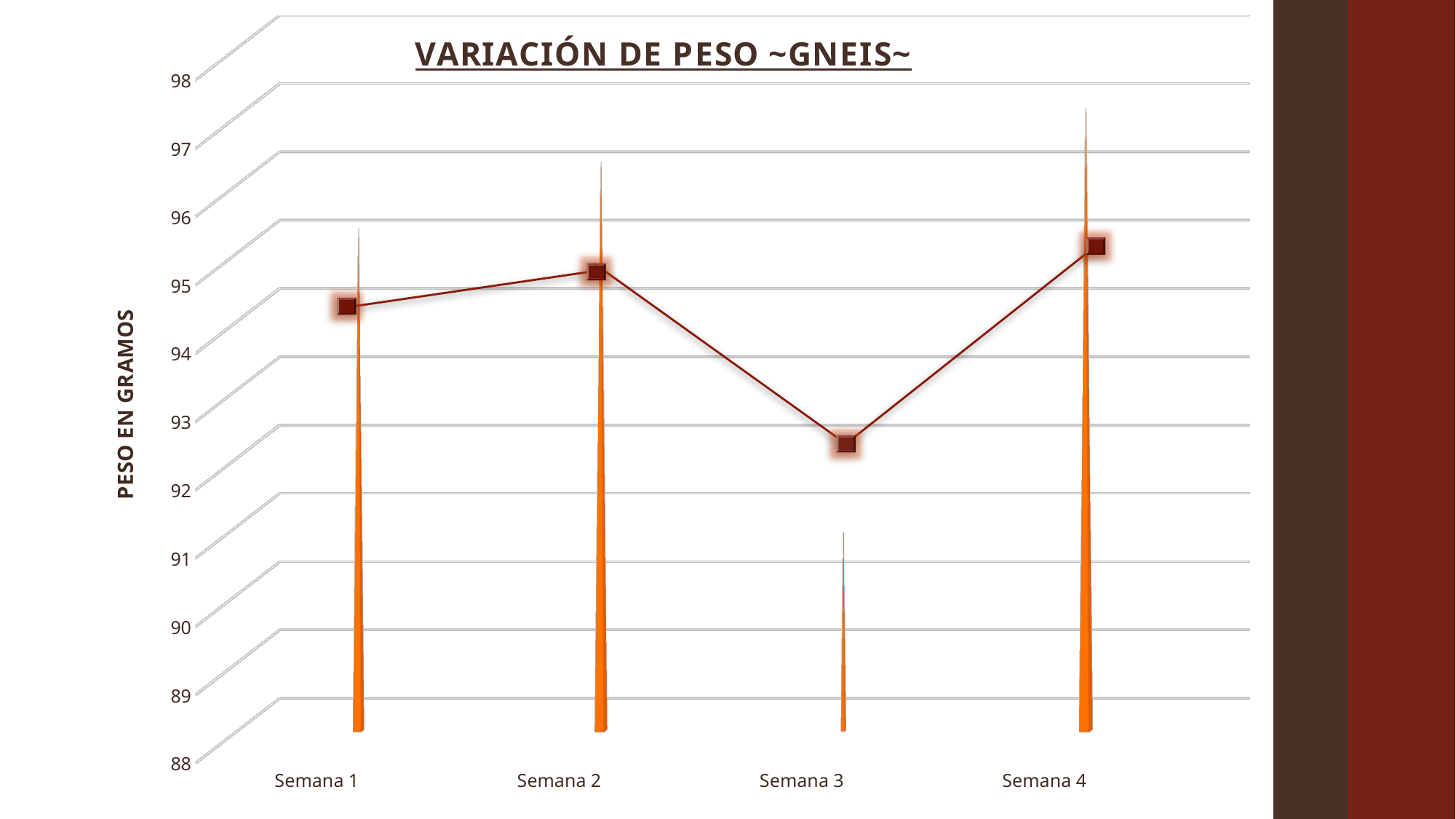
Which week has the shortest bar? Semana 3 Is the line value for Semana 1 greater or less than 95? less What is the label of the vertical axis? PESO EN GRAMOS Which week has the tallest bar? Semana 4 Is the bar for Semana 4 greater or less than 97? greater Which week has the highest value on the line? Semana 4 What kind of chart is this? bar and line chart Is the line value for Semana 3 greater or less than 93? less What is the title of the chart? VARIACIÓN DE PESO ~GNEIS~ How many weeks (categories) are shown on the x axis? 4 Does the line rise or fall from Semana 2 to Semana 3? fall Which week has the lowest value on the line? Semana 3